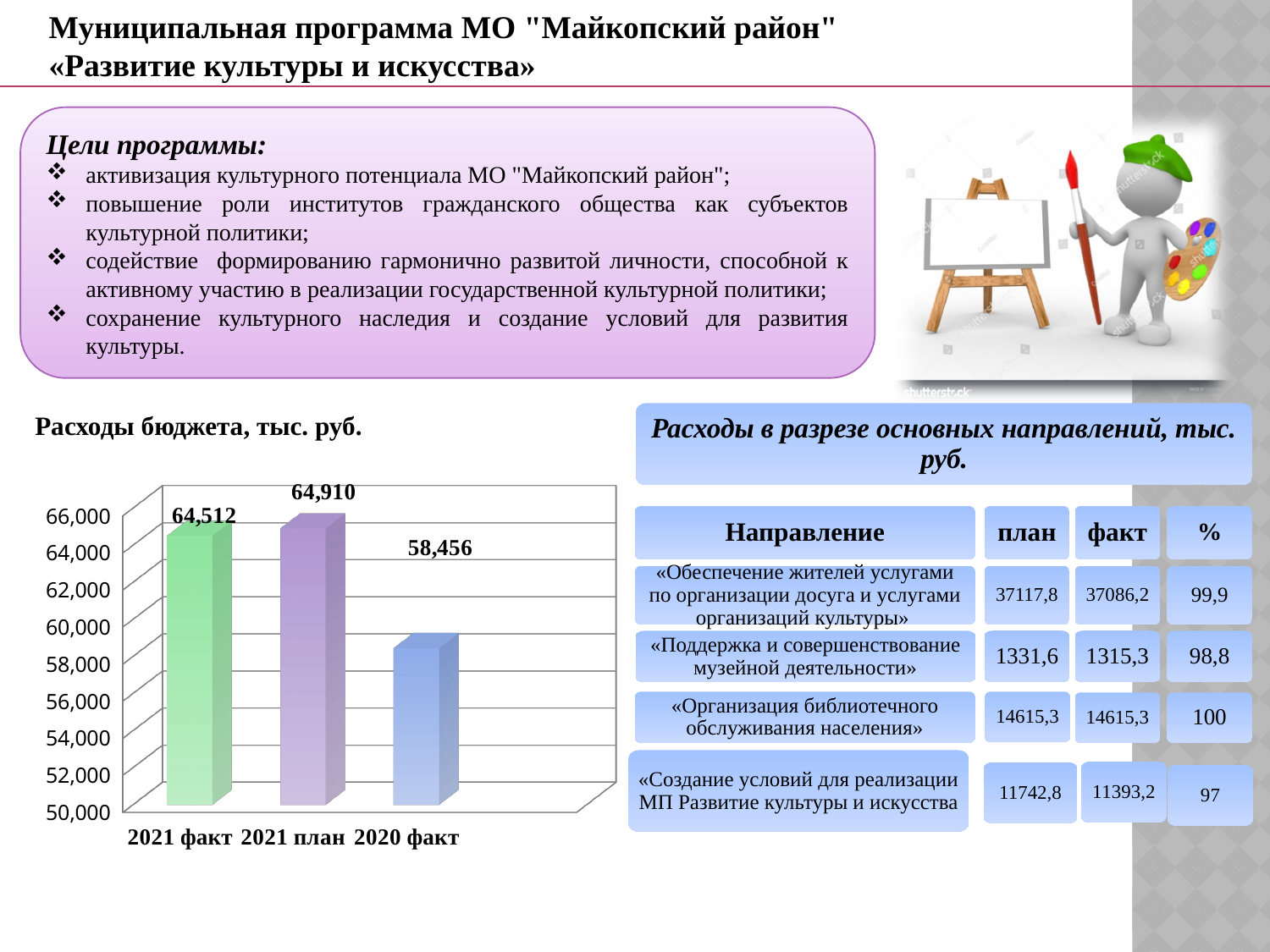
What is the title of the chart on the left side of the slide? Расходы бюджета, тыс. руб. In the chart "Расходы бюджета, тыс. руб.", what is the difference between 2021 план and 2021 факт? 398 In the chart "Расходы бюджета, тыс. руб.", which is larger: 2021 факт or 2020 факт? 2021 факт What kind of chart is "Расходы бюджета, тыс. руб."? bar chart What is the value for 2021 план in the chart "Расходы бюджета, тыс. руб."? 64,910 In the chart "Расходы бюджета, тыс. руб.", what is the difference between 2021 факт and 2020 факт? 6,056 What is the value for 2020 факт in the chart "Расходы бюджета, тыс. руб."? 58,456 Which category has the lowest value in the chart "Расходы бюджета, тыс. руб."? 2020 факт What is the value for 2021 факт in the chart "Расходы бюджета, тыс. руб."? 64,512 Which category has the highest value in the chart "Расходы бюджета, тыс. руб."? 2021 план In the chart "Расходы бюджета, тыс. руб.", is the value for 2020 факт greater or less than 60,000? less How many bars are shown in the chart "Расходы бюджета, тыс. руб."? 3